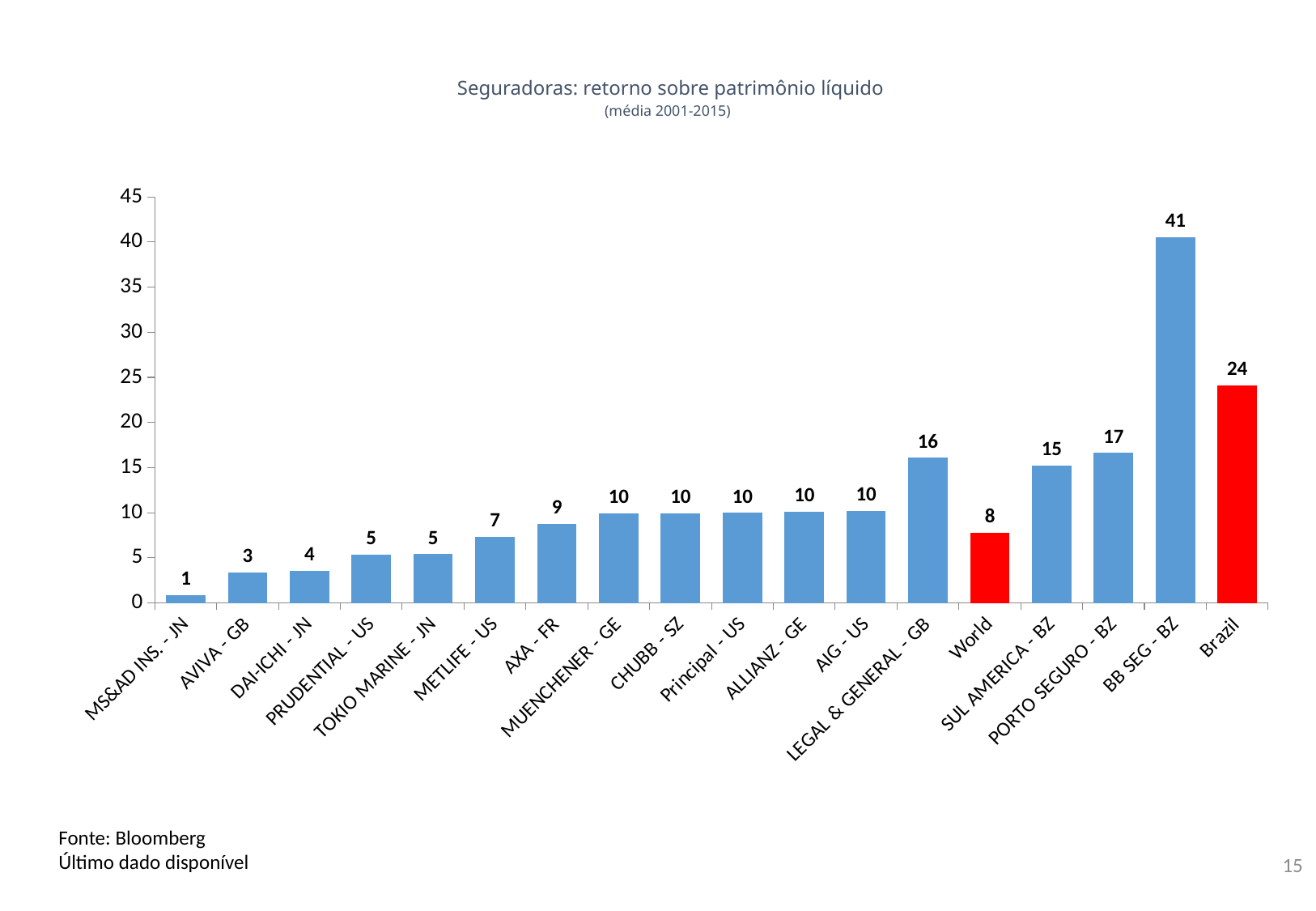
Is the value for Brazil greater or less than 20? greater What is the difference between the values for BB SEG - BZ and Brazil? 17 How many categories are shown on the x axis? 18 What is the value for World? 8 Which is larger, the value for LEGAL & GENERAL - GB or the value for SUL AMERICA - BZ? LEGAL & GENERAL - GB Which category has the lowest value? MS&AD INS. - JN What is the value for PORTO SEGURO - BZ? 17 What is the value for BB SEG - BZ? 41 What kind of chart is shown on the slide? Bar chart What is the title of the chart? Seguradoras: retorno sobre patrimônio líquido (média 2001-2015) What is the value for Brazil? 24 Which category has the highest value? BB SEG - BZ